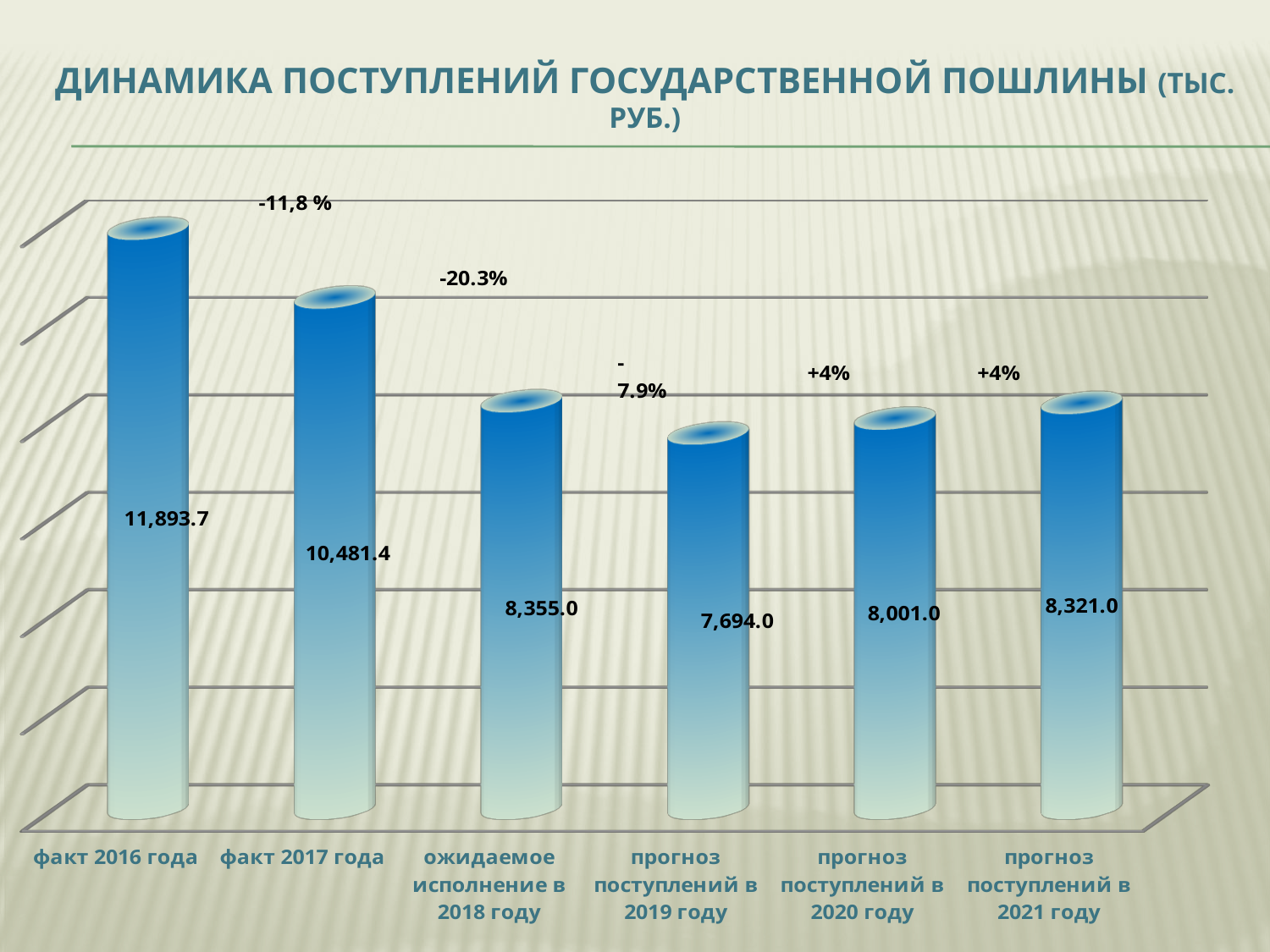
What is the value for факт 2017 года? 10,481.4 Which category has the highest value? факт 2016 года What is the value for ожидаемое исполнение в 2018 году? 8,355.0 What is the value for факт 2016 года? 11,893.7 What is the difference between the values for факт 2016 года and факт 2017 года? 1,412.3 Do the values rise or fall from факт 2016 года to прогноз поступлений в 2019 году? fall Which is larger, the value for ожидаемое исполнение в 2018 году or the value for прогноз поступлений в 2020 году? ожидаемое исполнение в 2018 году What is the value for прогноз поступлений в 2021 году? 8,321.0 How many categories are shown on the chart? 6 Which category has the lowest value? прогноз поступлений в 2019 году What is the difference between the values for прогноз поступлений в 2021 году and прогноз поступлений в 2020 году? 320.0 What is the value for прогноз поступлений в 2019 году? 7,694.0